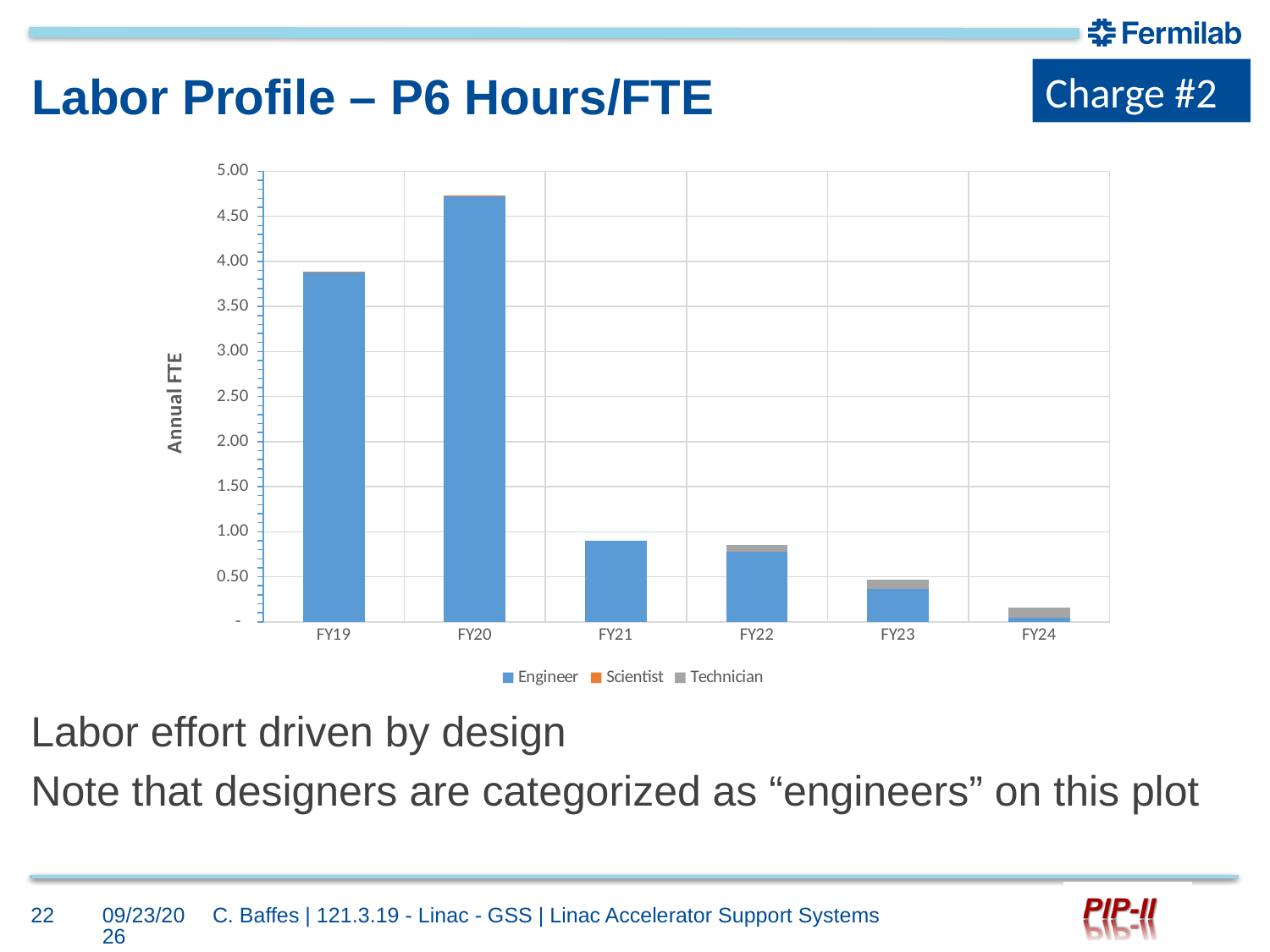
Do the total Annual FTE values rise or fall from FY20 to FY24? fall Is the total Annual FTE for FY20 greater or less than 4.50? greater Which fiscal year has the lowest total Annual FTE? FY24 Which fiscal year has the highest total Annual FTE? FY20 How many fiscal years are shown on the x axis of the chart? 6 How many series does the chart legend list? 3 Is the total Annual FTE for FY19 greater or less than 3.50? greater What kind of chart is shown on the slide? bar chart What is the label on the vertical axis of the chart? Annual FTE Which has a larger total Annual FTE, FY19 or FY21? FY19 Is the total Annual FTE for FY21 greater or less than 1.00? less